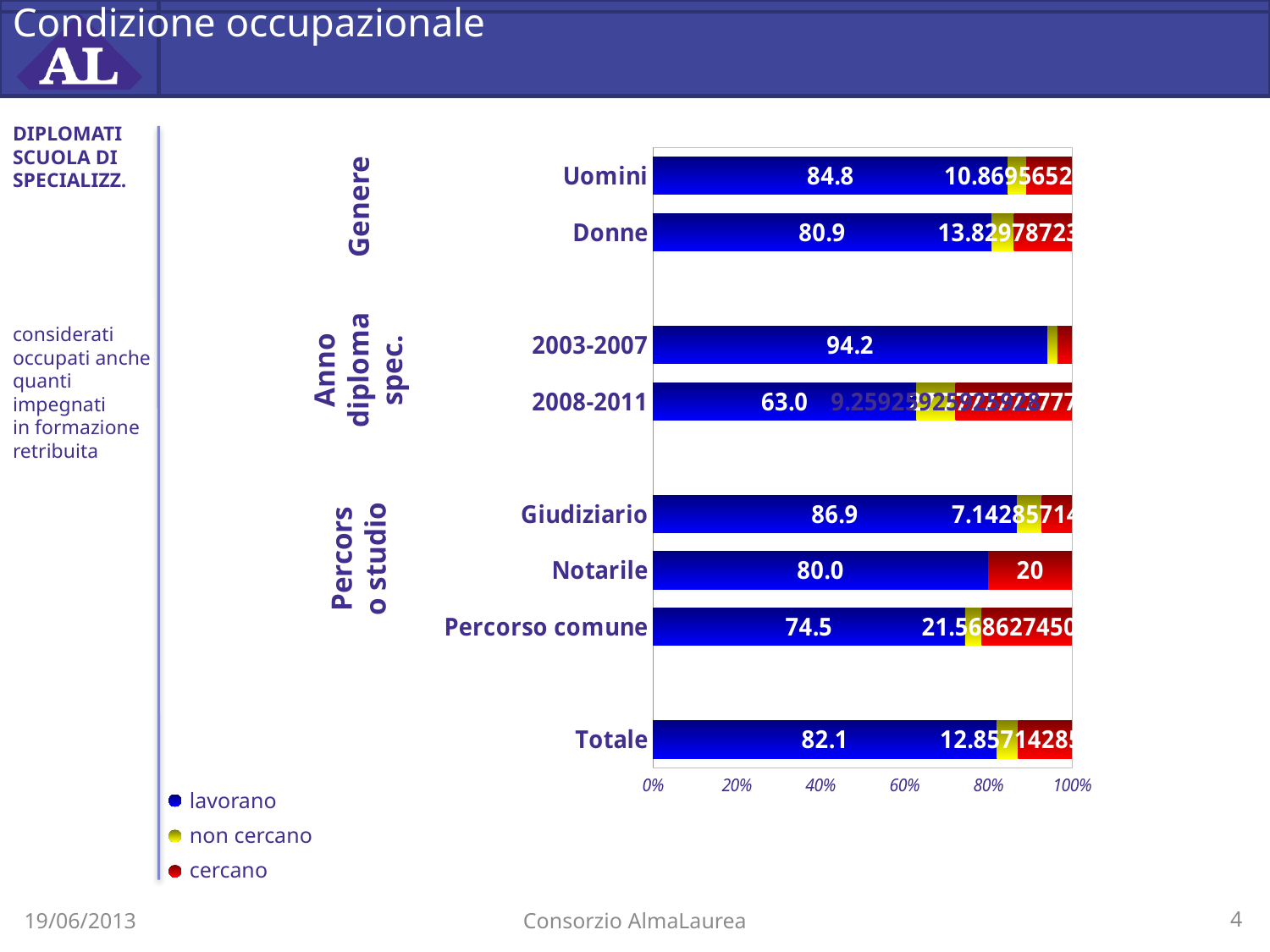
What is the 'cercano' value for Notarile? 20 What is the 'lavorano' value for Donne? 80.9 What is the 'lavorano' value for Uomini? 84.8 What is the difference between the 'lavorano' values for Uomini and Donne? 3.9 What is the 'lavorano' value for Totale? 82.1 What is the 'lavorano' value for 2008-2011? 63.0 What kind of chart is shown on the slide? bar chart How many series does the legend list? 3 Which category has the highest 'lavorano' value? 2003-2007 Which category has the lowest 'lavorano' value? 2008-2011 Which has a larger 'lavorano' value, Giudiziario or Percorso comune? Giudiziario What is the 'lavorano' value for 2003-2007? 94.2